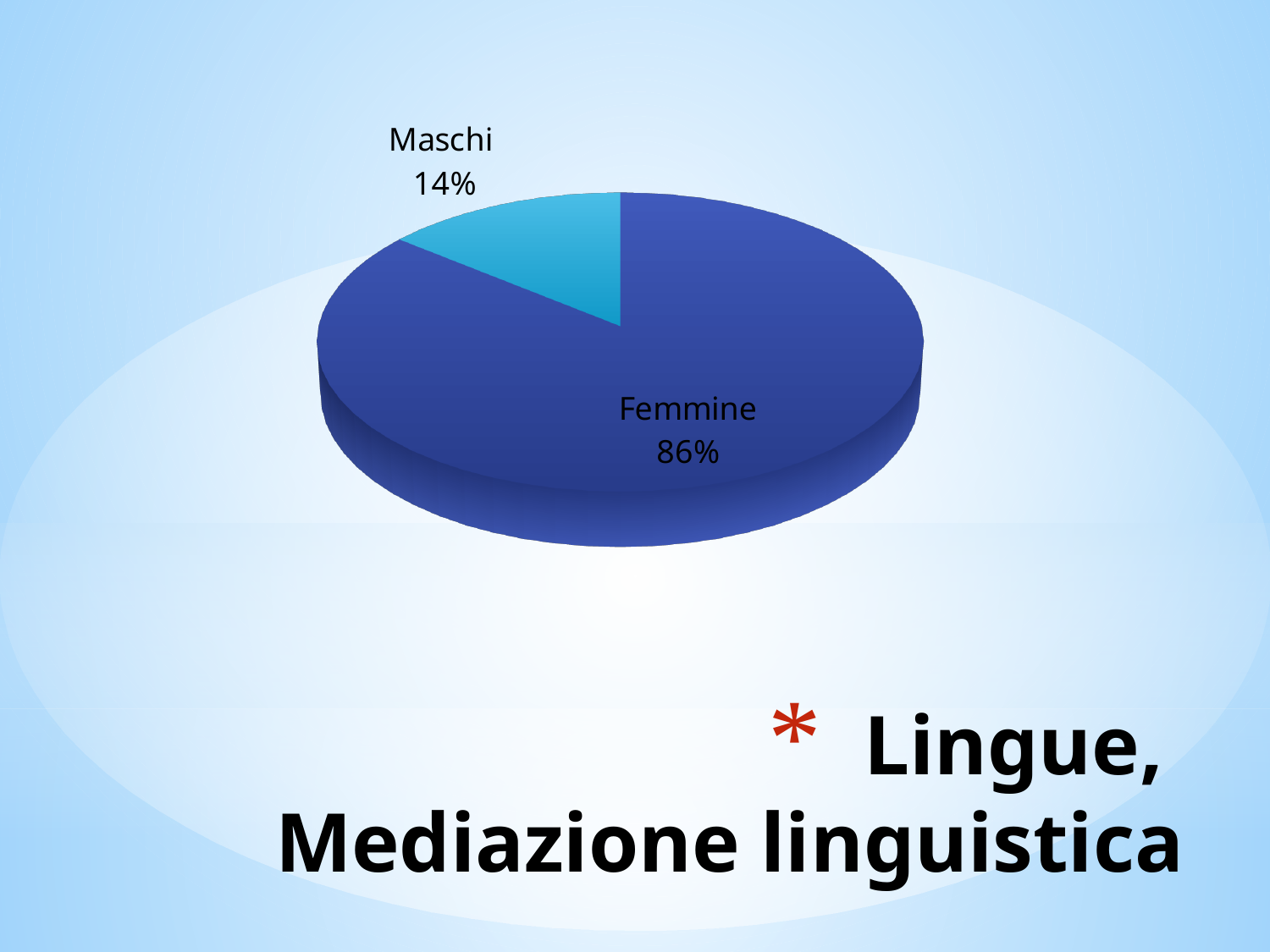
What percentage of the pie is Femmine? 86% What colour is the Maschi slice? light blue What share of the pie does the Maschi slice represent? 14% Which is larger, the Maschi slice or the Femmine slice? Femmine Which slice of the pie is the smallest? Maschi What text appears below the chart on the slide? Lingue, Mediazione linguistica What percentage of the pie is Maschi? 14% What kind of chart is shown on the slide? pie chart What is the difference in percentage points between Femmine and Maschi? 72 How many slices does the pie chart have? 2 Which slice of the pie is the largest? Femmine